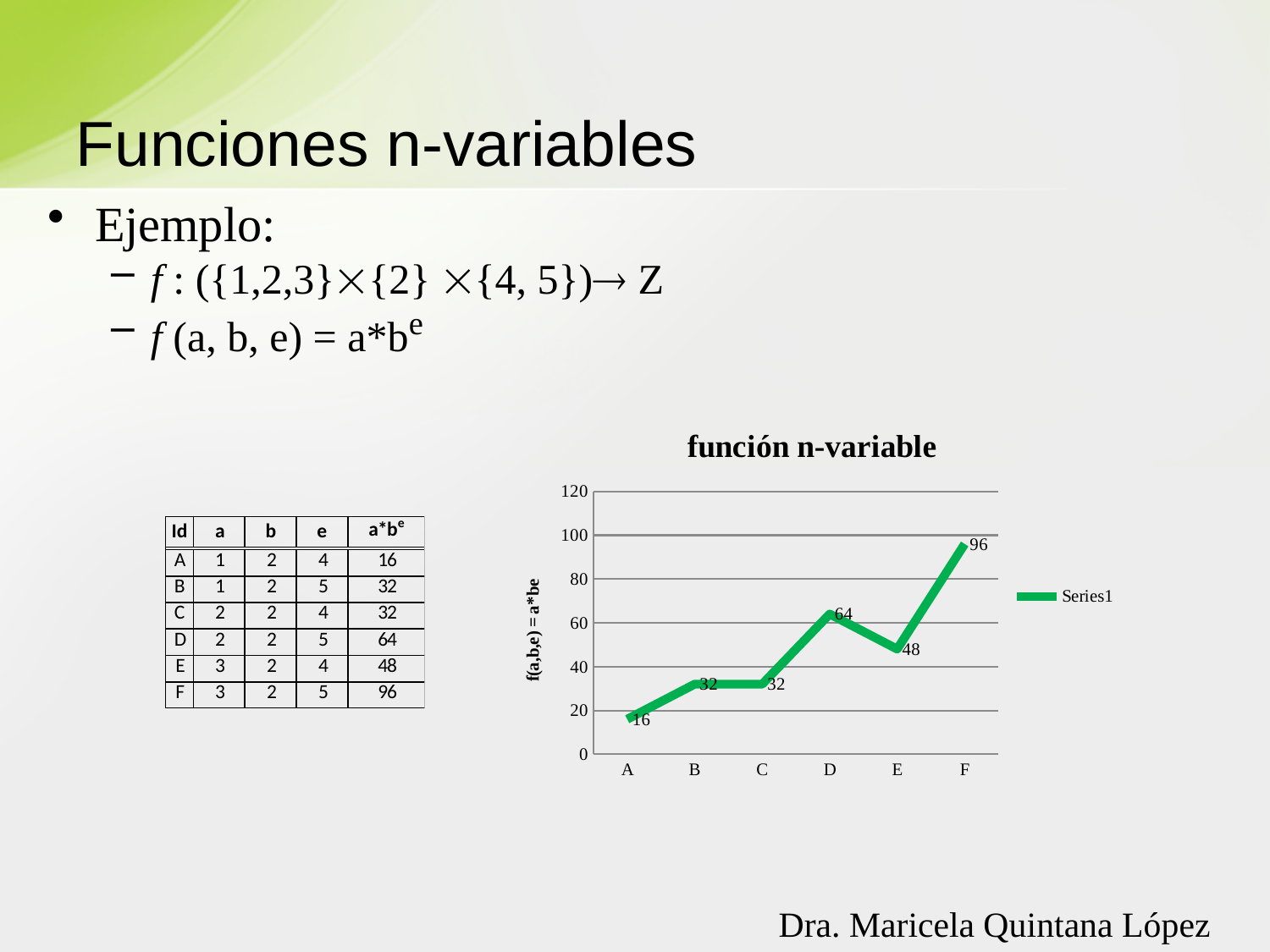
Is the value for F greater or less than 80? greater What is the difference between the values for F and D? 32 Which category has the lowest value in the chart? A Which category has the highest value in the chart? F What is the value for category E in the chart? 48 What is the difference between the values for E and A? 32 What kind of chart is shown on the slide? line chart How many categories are shown on the x axis of the chart? 6 Which is larger, the value for D or the value for E? D What is the title of the chart? función n-variable What is the value for category D in the chart? 64 What is the value for category A in the chart? 16